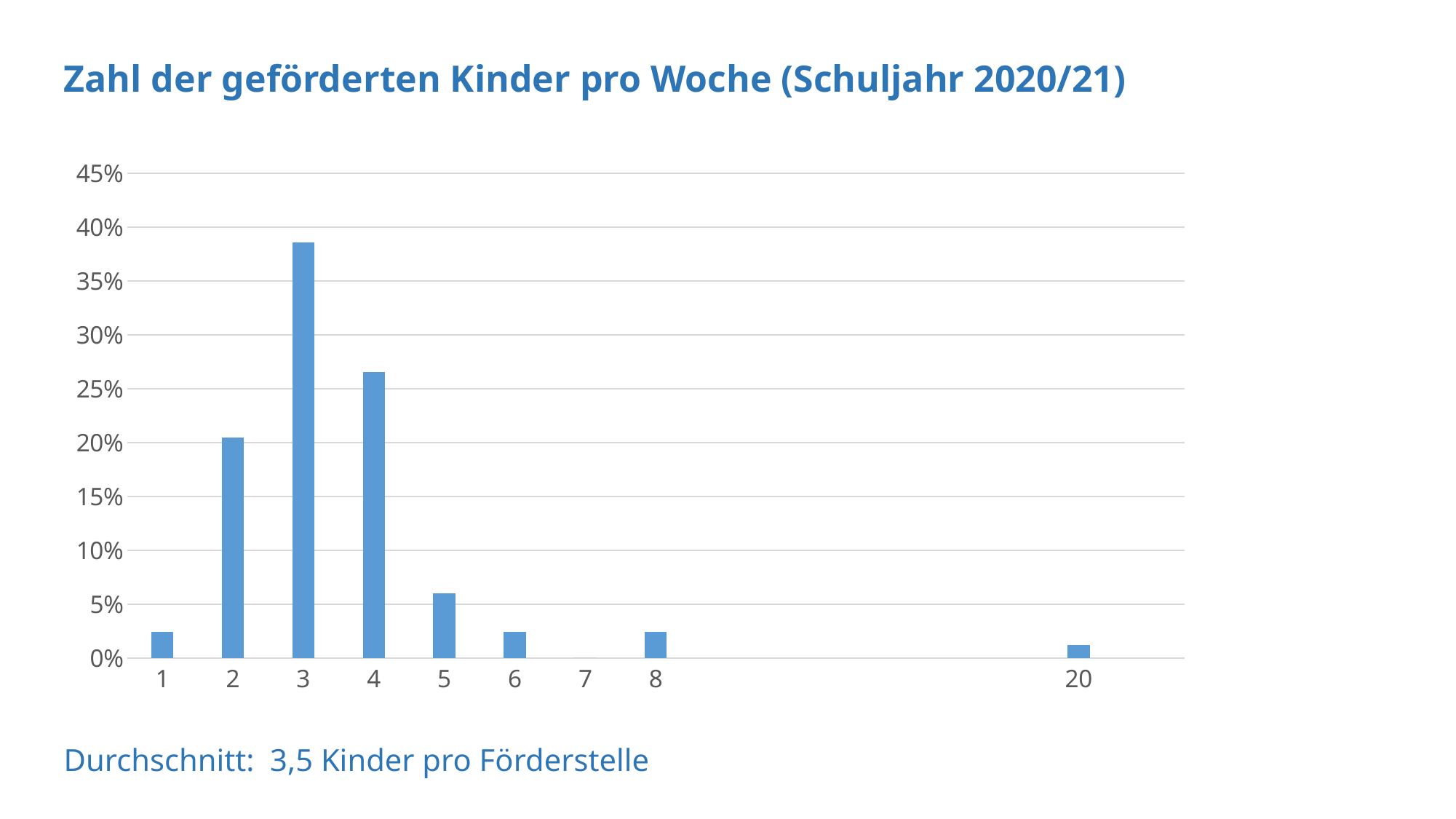
What is the title of the chart? Zahl der geförderten Kinder pro Woche (Schuljahr 2020/21) Is the value for category 3 greater or less than 35%? greater Is the value for category 2 greater or less than 15%? greater What kind of chart is shown on the slide? bar chart Is the value for category 1 greater or less than 5%? less What average is stated below the chart? 3,5 Kinder pro Förderstelle Which is larger, the value for category 2 or category 4? 4 Which category has the highest bar? 3 Which is larger, the value for category 5 or category 6? 5 How many category labels are shown on the x axis? 9